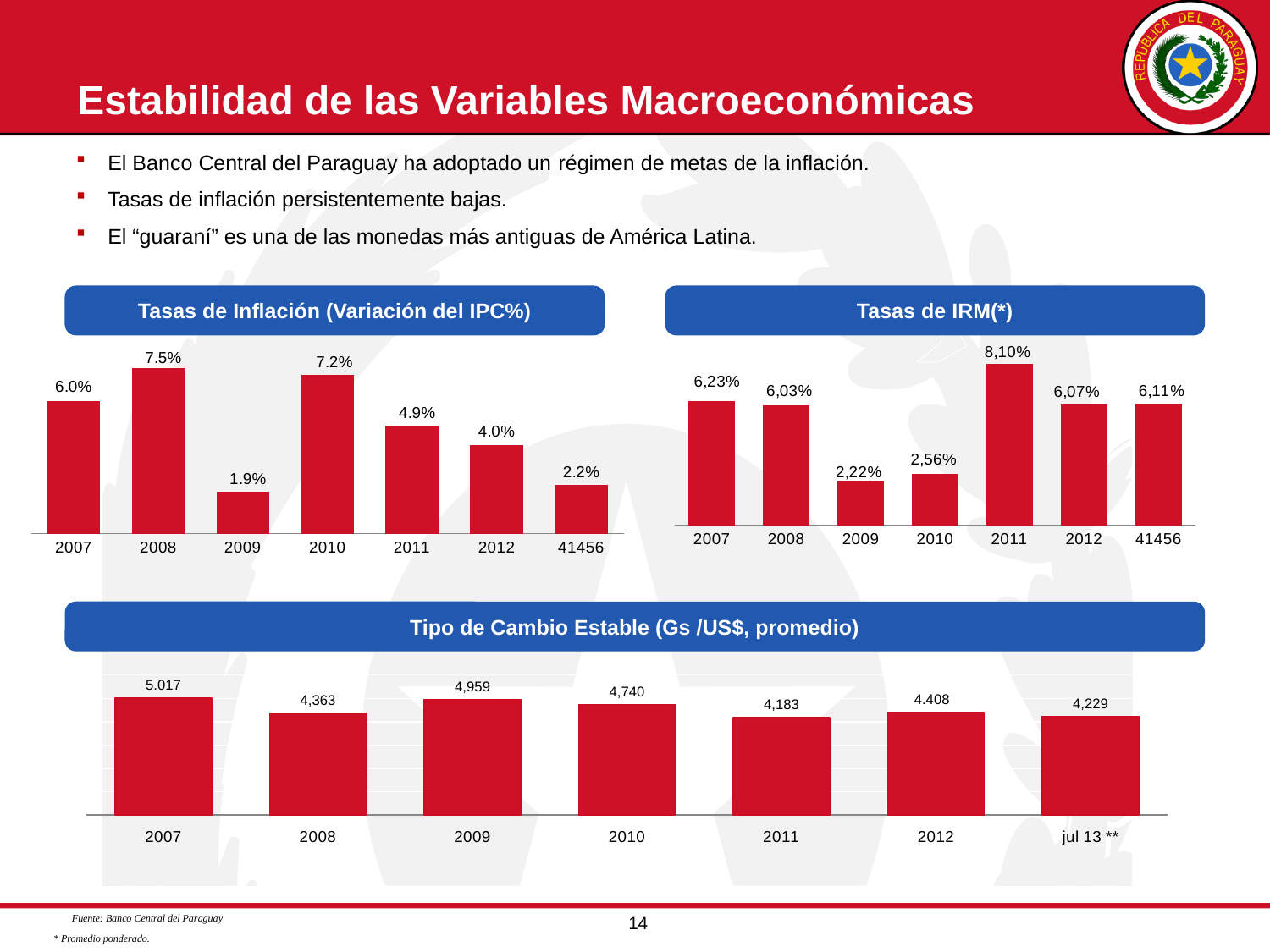
In the 'Tasas de Inflación (Variación del IPC%)' chart, which year has the lowest value? 2009 In the 'Tasas de IRM(*)' chart, what is the value for 2011? 8,10% In the 'Tasas de IRM(*)' chart, what is the value for 2007? 6,23% In the 'Tipo de Cambio Estable (Gs /US$, promedio)' chart, what is the value for 2011? 4,183 In the 'Tasas de IRM(*)' chart, which year has the highest value? 2011 In the 'Tasas de Inflación (Variación del IPC%)' chart, how many bars are plotted? 7 What kind of chart is the 'Tipo de Cambio Estable (Gs /US$, promedio)' chart? Bar chart In the 'Tipo de Cambio Estable (Gs /US$, promedio)' chart, which category has the highest value? 2007 In the 'Tipo de Cambio Estable (Gs /US$, promedio)' chart, what is the value for jul 13 **? 4,229 In the 'Tasas de Inflación (Variación del IPC%)' chart, what is the difference between the 2010 and 2012 values? 3.2% In the 'Tasas de Inflación (Variación del IPC%)' chart, what is the value for 2008? 7.5% In the 'Tasas de IRM(*)' chart, which is larger, the value for 2009 or the value for 2010? 2010